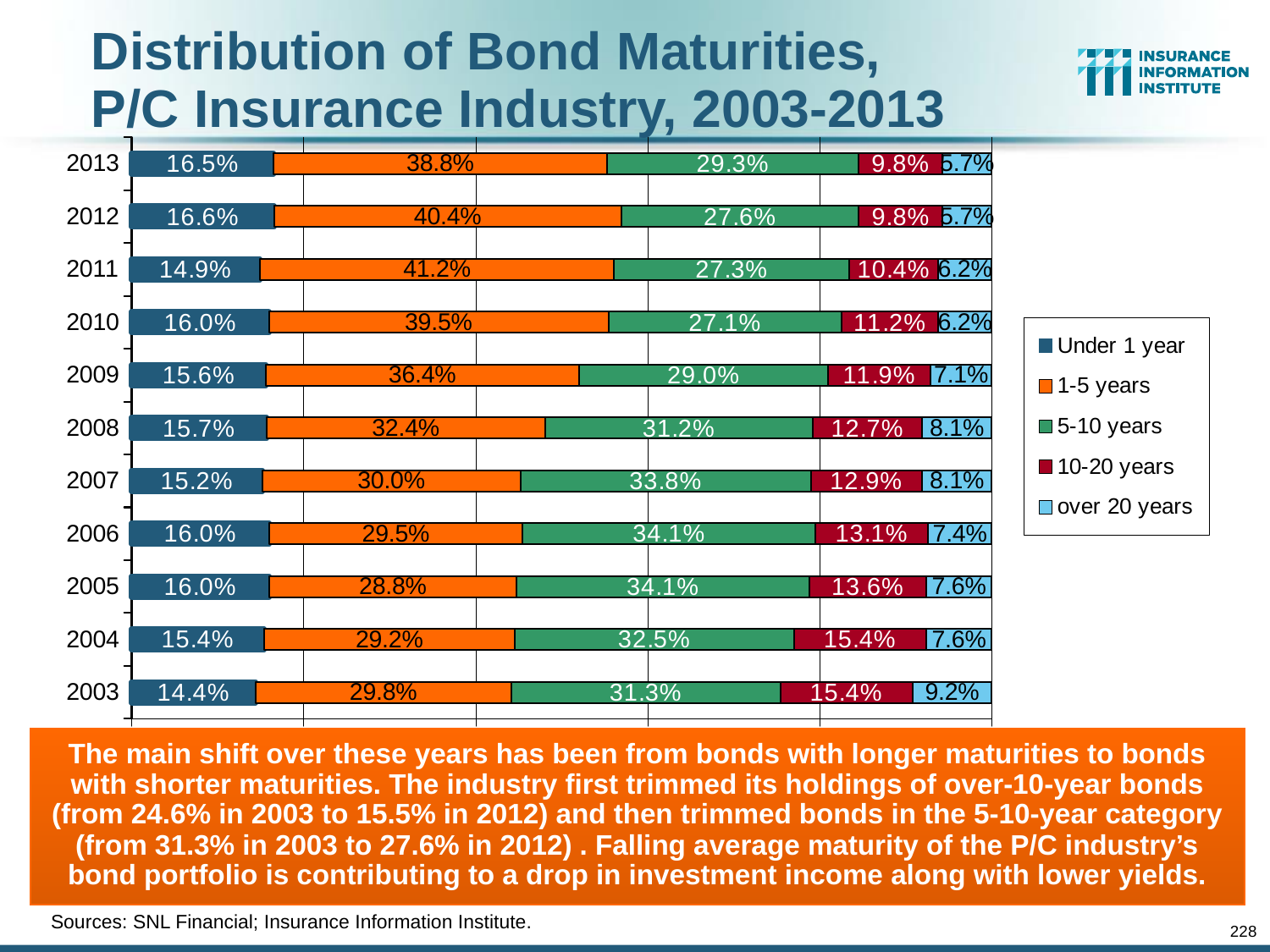
How many maturity categories does the legend list? 5 Which year had a larger 5-10 years share, 2007 or 2008? 2007 What was the over 20 years share in 2003? 9.2% Did the share of bonds in the 1-5 years category generally rise or fall from 2003 to 2013? Rise Which year had the lowest share of bonds in the Under 1 year category? 2003 How many years are shown on the chart? 11 Which maturity category is shown in orange? 1-5 years What type of chart is shown on the slide? Stacked bar chart What was the 5-10 years share in 2006? 34.1% By how many percentage points did the 10-20 years share fall from 2003 to 2013? 5.6 percentage points Which year had the highest share of bonds in the 1-5 years category? 2011 What share of bonds had maturities of 1-5 years in 2011? 41.2%